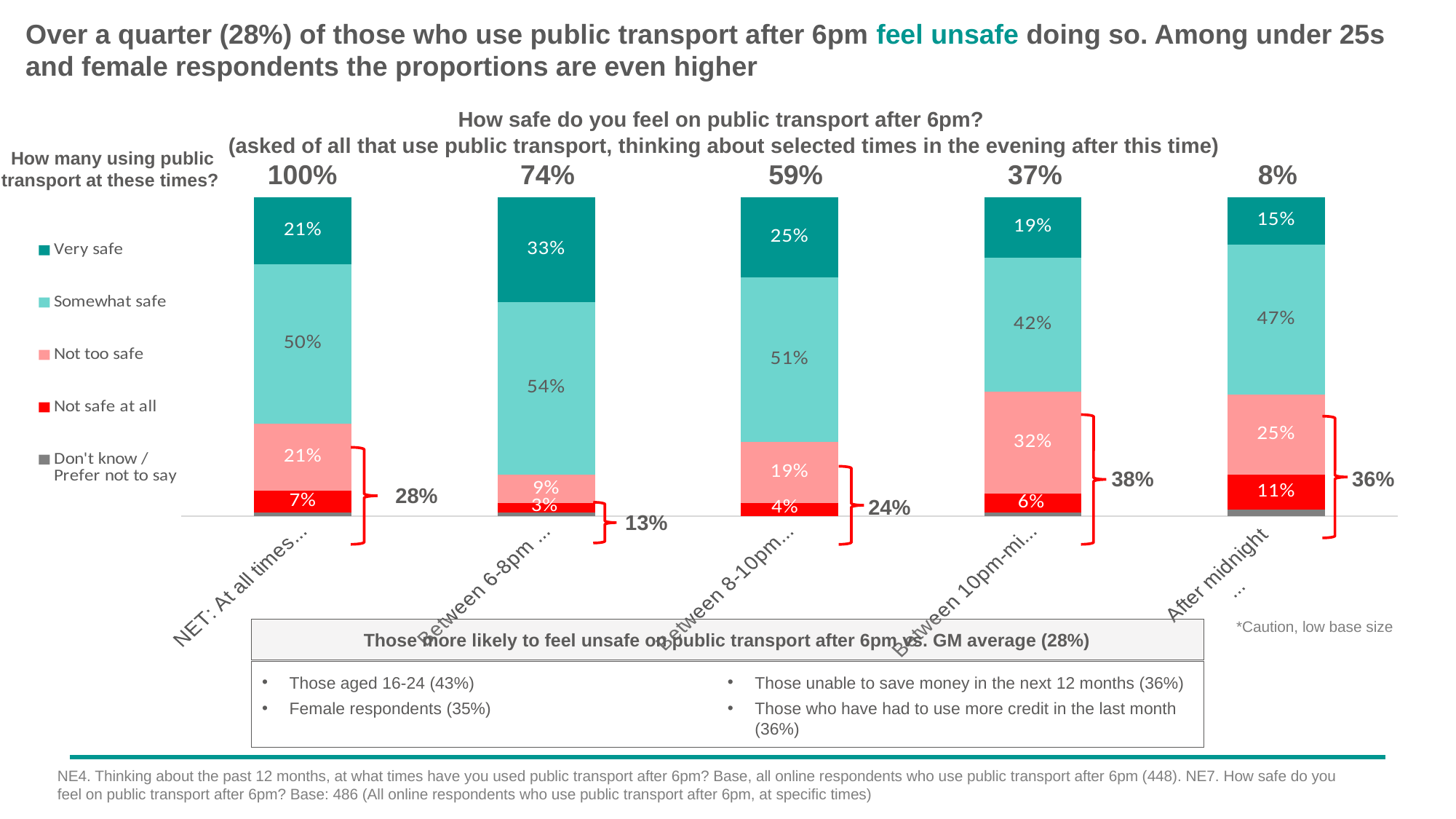
What percentage said they feel not too safe on public transport between 10pm and midnight? 32% How many percentage points higher is the very safe share for between 6-8pm than for NET: At all times? 12 percentage points How many response categories does the legend list? 5 Which time period has the lowest percentage of respondents feeling not safe at all? Between 6-8pm What combined unsafe percentage is shown by the bracket for the between 10pm-midnight bar? 38% Which time period has the highest percentage of respondents feeling somewhat safe? Between 6-8pm Does the not safe at all share rise or fall moving from between 6-8pm to after midnight? Rises What percentage of respondents said they feel very safe on public transport between 6-8pm? 33% What type of chart is used to show how safe people feel on public transport after 6pm? Stacked bar chart How many time-period bars are shown in the chart? 5 Which has a larger not too safe share: after midnight or between 8-10pm? After midnight What percentage of respondents use public transport after midnight, as shown above the bar? 8%